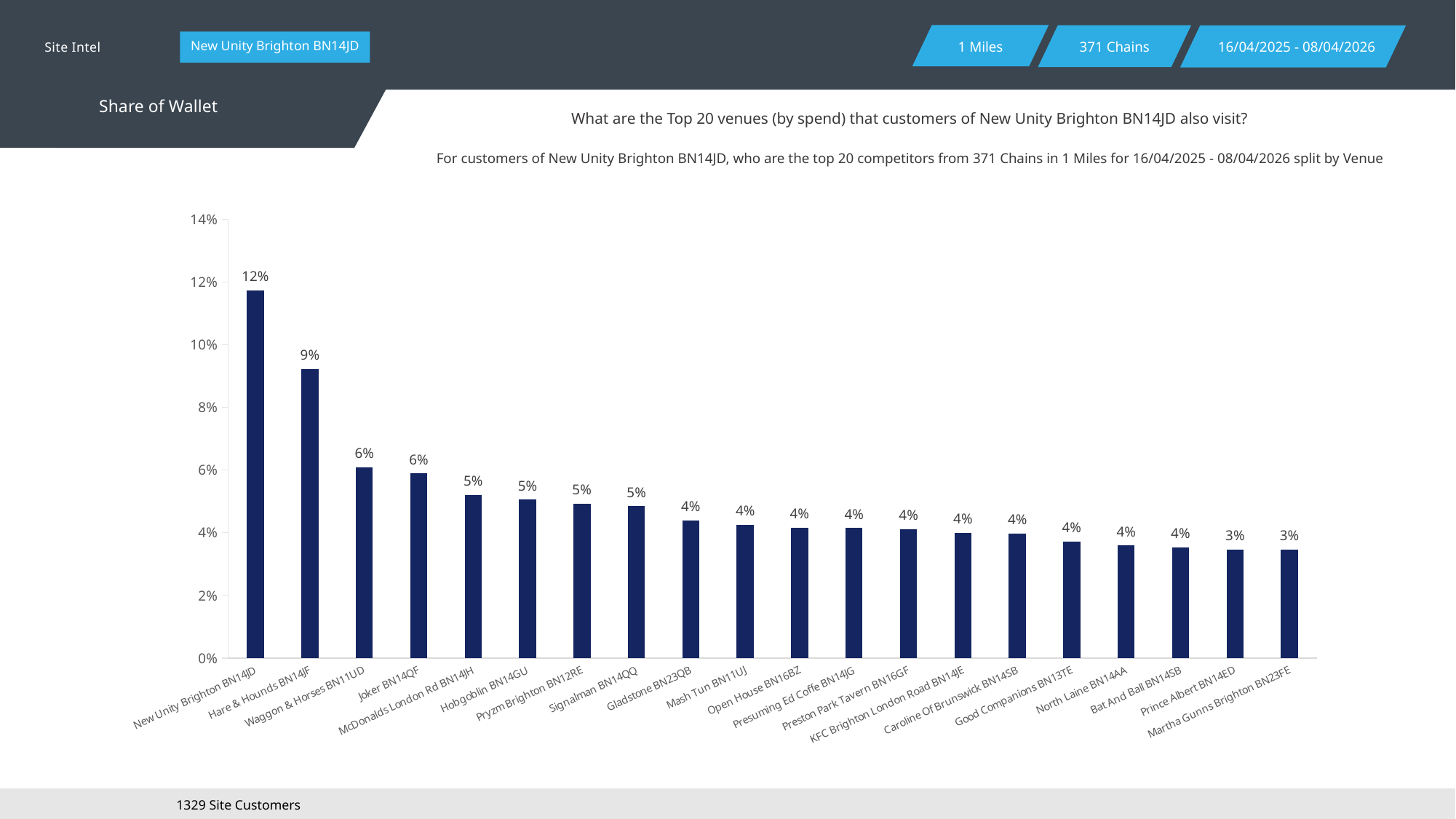
Do the values rise or fall from left to right along the x axis? Fall What is the value for Hobgoblin BN14GU? 5% Which is larger, the value for Hare & Hounds BN14JF or the value for Joker BN14QF? Hare & Hounds BN14JF What is the value for Hare & Hounds BN14JF? 9% What kind of chart is shown on the slide? Bar chart Which venue has the highest value? New Unity Brighton BN14JD Is the value for Waggon & Horses BN11UD greater or less than 8%? less What is the value for New Unity Brighton BN14JD? 12% Is the value for Hare & Hounds BN14JF greater or less than 8%? greater What is the difference between the values for New Unity Brighton BN14JD and Hare & Hounds BN14JF? 3% How many venues are shown on the chart? 20 What is the value for Prince Albert BN14ED? 3%